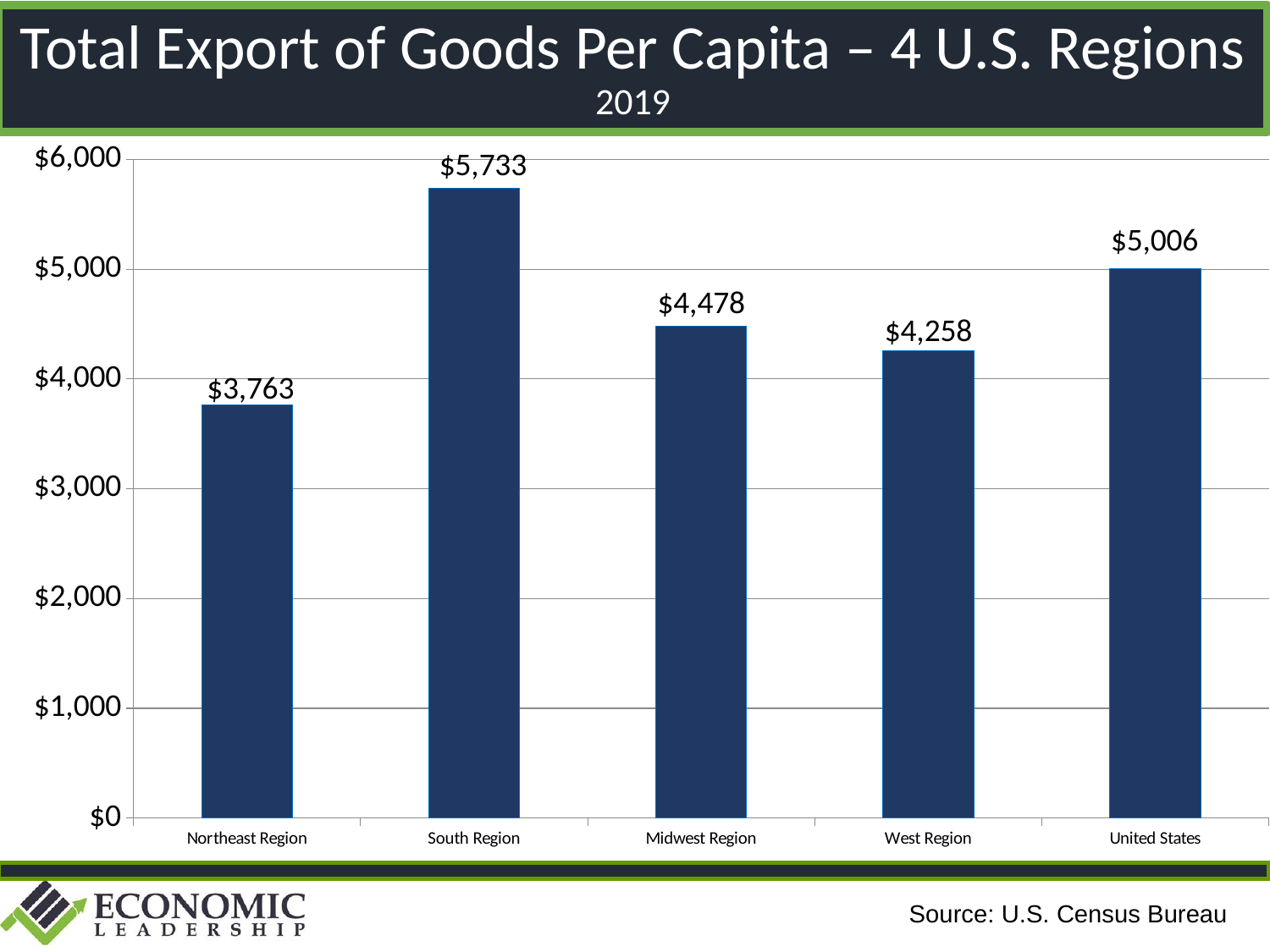
What is the value shown for the United States? $5,006 What year does the chart cover? 2019 What is the total export of goods per capita for the Northeast Region? $3,763 What is the difference between the South Region and the Northeast Region values? $1,970 What kind of chart is shown on the slide? Bar chart Which category has the lowest export of goods per capita? Northeast Region What is the total export of goods per capita for the South Region? $5,733 Which category has the highest export of goods per capita? South Region Which is larger, the value for the Midwest Region or the West Region? Midwest Region How many bars are shown in the chart? 5 What is the difference between the Midwest Region and West Region values? $220 Is the value for the United States greater or less than $5,000? greater